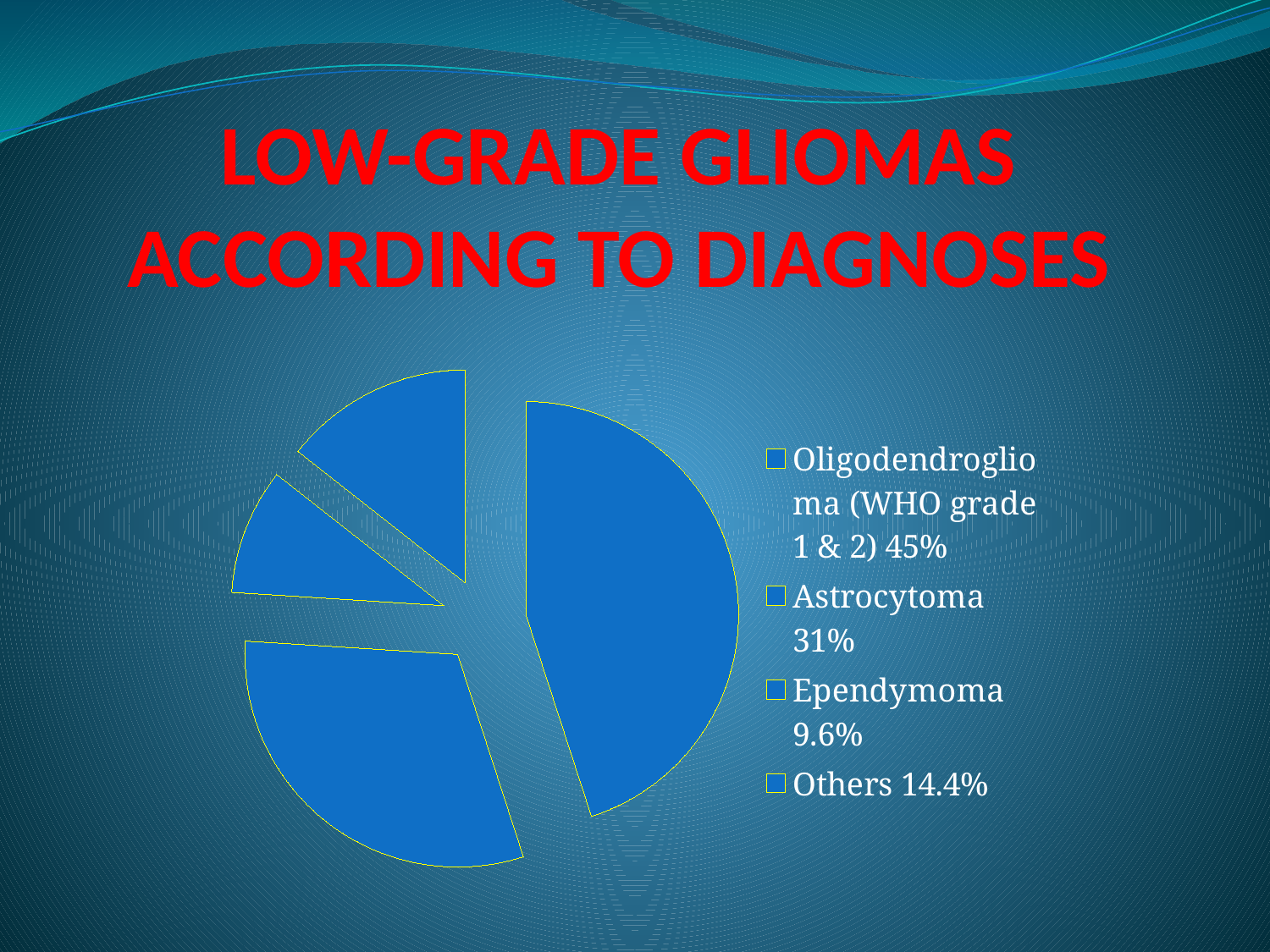
What percentage is shown for Astrocytoma in the pie chart legend? 31% What is the title of the slide containing the pie chart? LOW-GRADE GLIOMAS ACCORDING TO DIAGNOSES What percentage is shown for Others in the pie chart legend? 14.4% Which diagnosis has the largest share of the pie chart? Oligodendroglioma (WHO grade 1 & 2) What type of chart is shown on the slide? pie chart What is the difference in percentage points between Others and Ependymoma? 4.8 What is the difference in percentage points between Oligodendroglioma (WHO grade 1 & 2) and Astrocytoma? 14 Which diagnosis has the smallest share of the pie chart? Ependymoma What percentage is shown for Oligodendroglioma (WHO grade 1 & 2) in the pie chart legend? 45% How many categories does the legend of the pie chart list? 4 What percentage is shown for Ependymoma in the pie chart legend? 9.6% Which has a larger share, Others or Ependymoma? Others